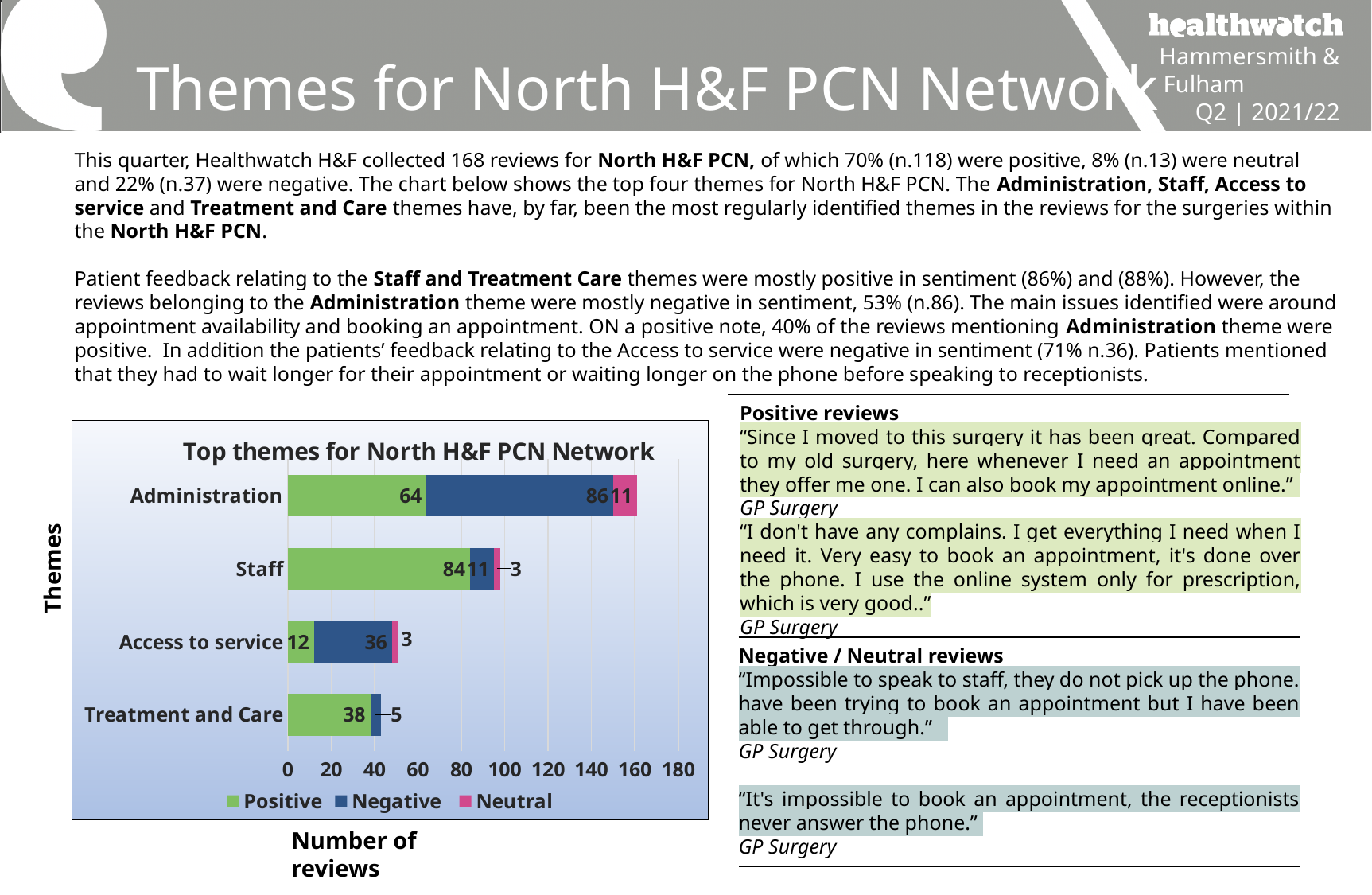
What is the Negative value for Administration? 86 What type of chart is shown on the slide? Stacked bar chart What is the total number of reviews in the Administration bar (Positive + Negative + Neutral)? 161 What is the difference between the Negative and Positive values for Administration? 22 What is the Neutral value for Administration? 11 What is the Negative value for Access to service? 36 For Access to service, which is larger: the Positive or the Negative value? Negative How many series does the legend of the chart list? 3 What is the title of the chart? Top themes for North H&F PCN Network Which theme has the highest Positive value? Staff How many themes (categories) are plotted in the chart? 4 What is the Positive value for Staff? 84